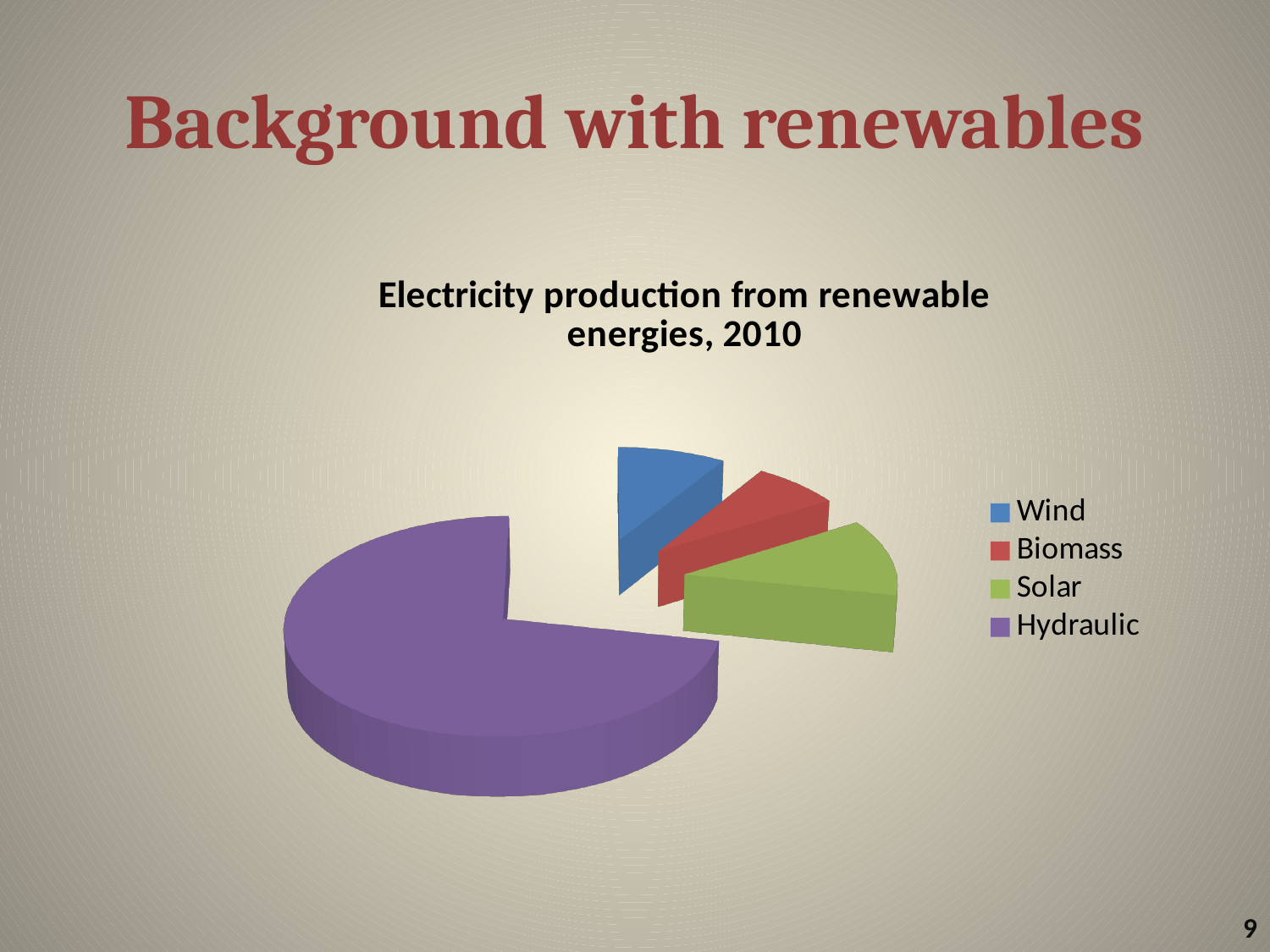
What is the title of the chart? Electricity production from renewable energies, 2010 Which category has the largest slice of the pie? Hydraulic What kind of chart is shown on the slide? Pie chart Which category has the smallest slice of the pie? Biomass Which slice is larger, Hydraulic or Solar? Hydraulic Which category is shown in green? Solar Which colour represents Hydraulic in the chart? Purple How many categories does the legend list? 4 Which slice is larger, Solar or Biomass? Solar